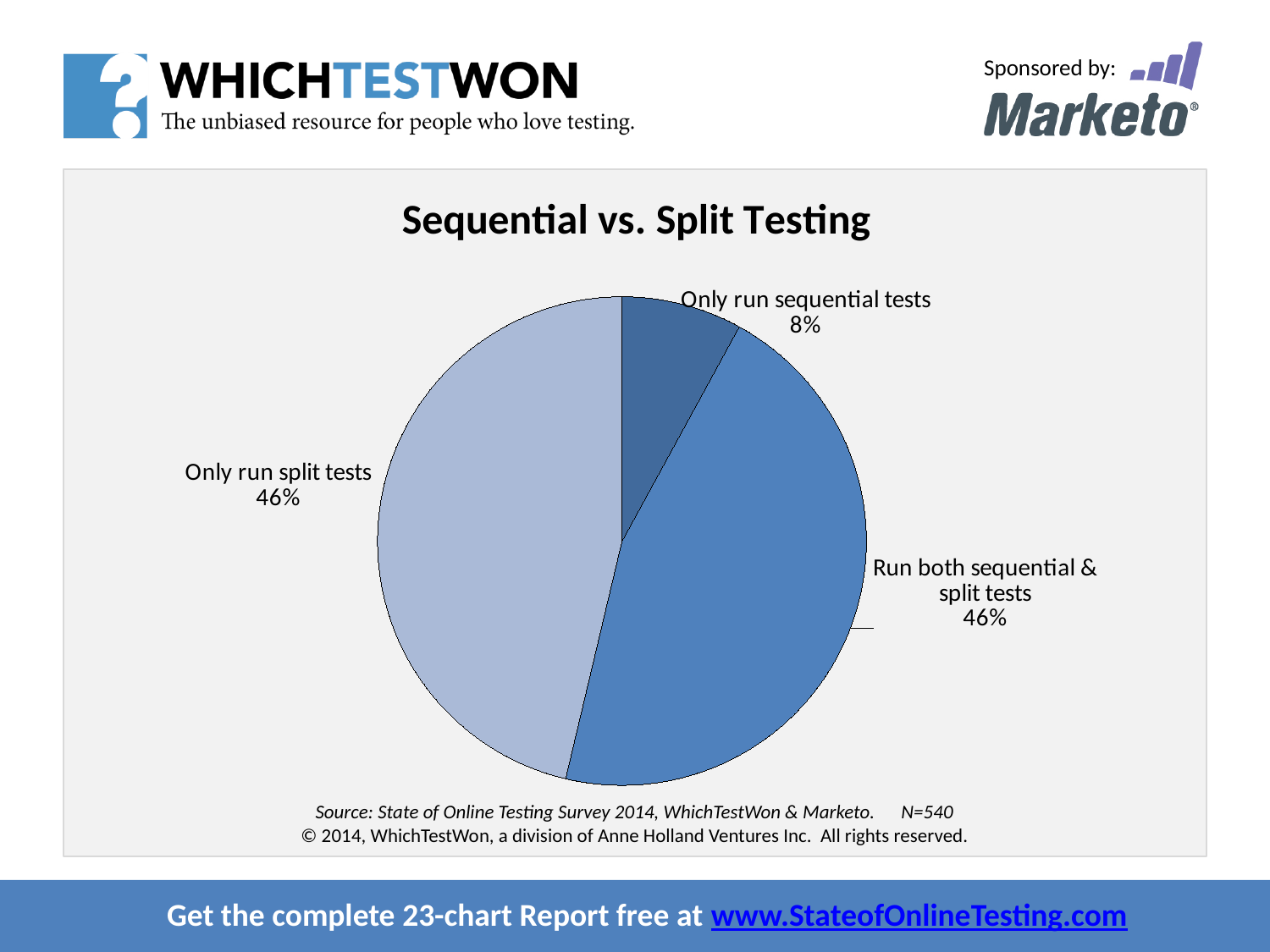
What percentage of respondents only run split tests? 46% What is the combined share of 'Only run split tests' and 'Run both sequential & split tests'? 92% Which is larger: the share for 'Run both sequential & split tests' or 'Only run sequential tests'? Run both sequential & split tests What is the difference between the share for 'Only run split tests' and 'Only run sequential tests'? 38 percentage points Which category has the smallest share of the pie? Only run sequential tests How many slices does the pie chart have? 3 What is the title of the chart? Sequential vs. Split Testing What type of chart is shown on the slide? pie chart What is the sample size (N) stated in the chart's source note? N=540 What percentage of respondents run both sequential & split tests? 46% What percentage of respondents only run sequential tests? 8%